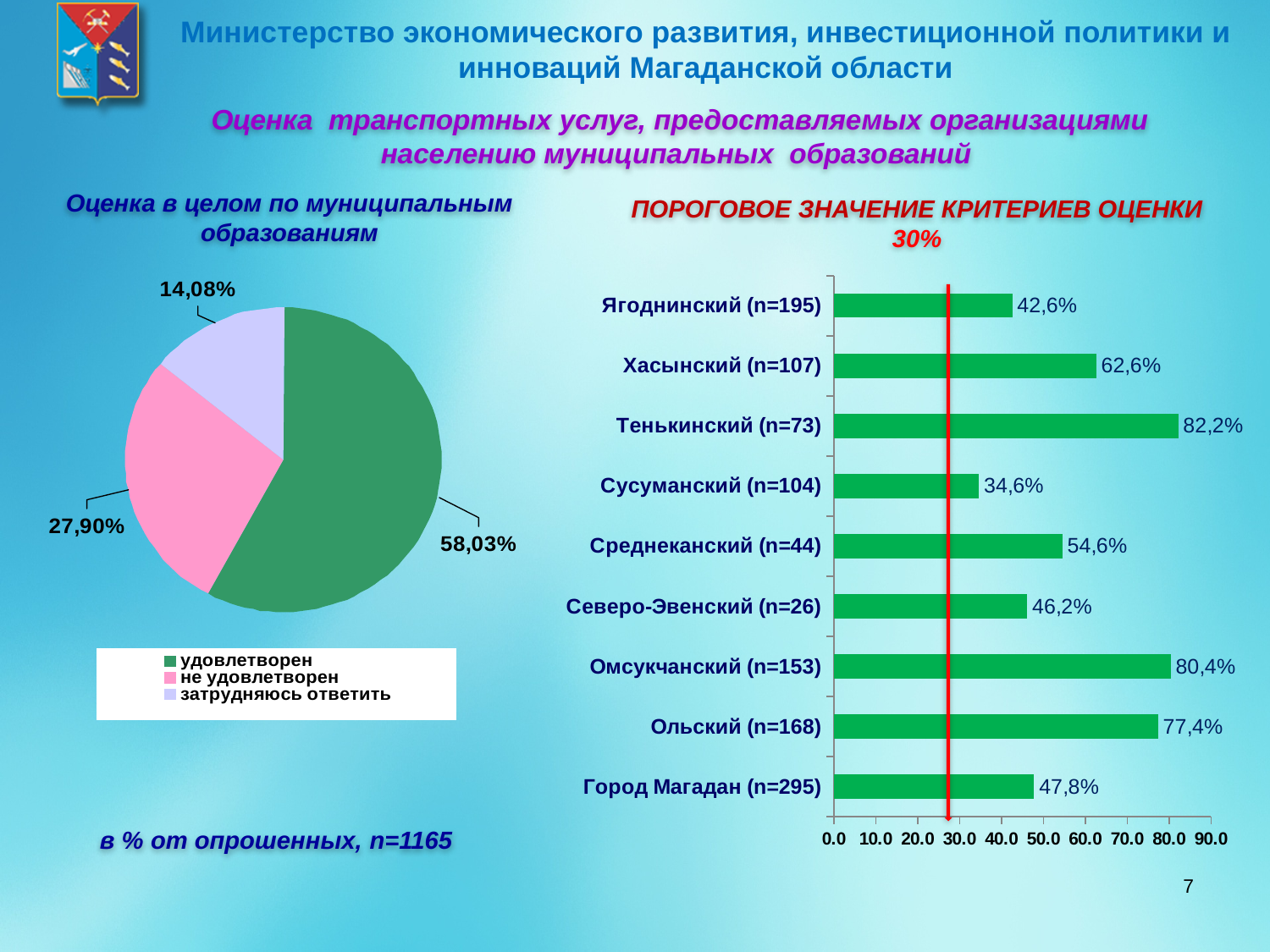
In the bar chart on the right, which municipality has the lowest value? Сусуманский (n=104) In the pie chart on the left, what share is labelled 'удовлетворен'? 58,03% In the bar chart on the right, which is larger: the value for Ольский (n=168) or Омсукчанский (n=153)? Омсукчанский (n=153) What type of chart is shown on the right side of the slide? Bar chart In the bar chart on the right, which municipality has the highest value? Тенькинский (n=73) In the bar chart on the right, what is the value for Тенькинский (n=73)? 82,2% In the pie chart on the left, how many categories does the legend list? 3 In the pie chart on the left, which is larger: 'не удовлетворен' or 'затрудняюсь ответить'? не удовлетворен In the bar chart on the right, what is the value for Город Магадан (n=295)? 47,8% In the bar chart on the right, what is the difference between the values for Хасынский (n=107) and Ягоднинский (n=195)? 20 percentage points In the bar chart on the right, how many municipalities are shown? 9 In the pie chart on the left, what is the value for 'затрудняюсь ответить'? 14,08%